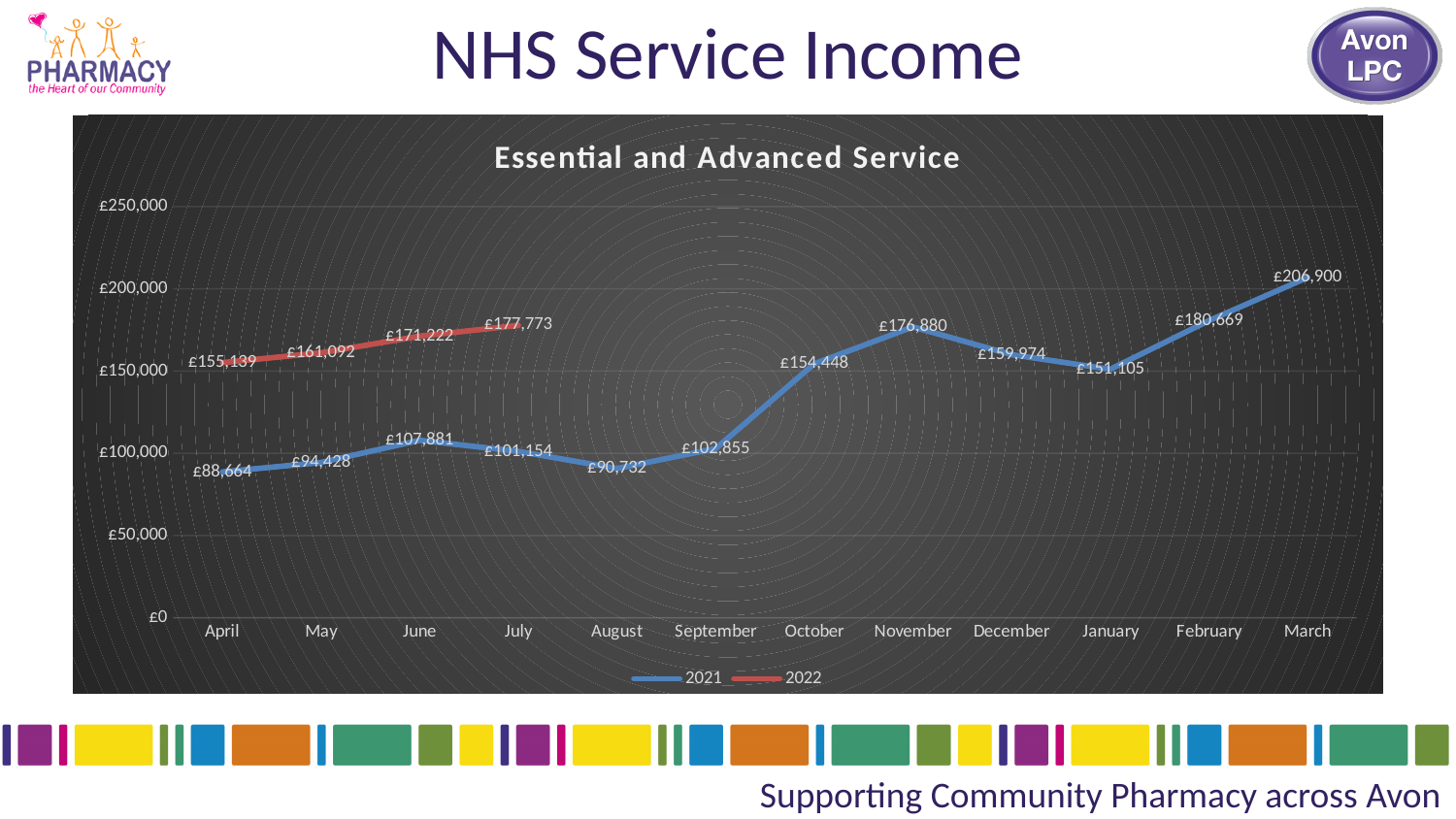
Which month has the lowest 2021 value? April What is the 2021 value for October? £154,448 Is the 2021 value for August greater or less than £100,000? less What is the difference between the 2022 and 2021 values for July? £76,619 How many series does the legend list? 2 What kind of chart is shown on the slide? Line chart Which month has the highest 2021 value? March Does the 2022 line rise or fall from April to July? Rises What is the title of the chart? Essential and Advanced Service What is the 2022 value for June? £171,222 Which is larger, the 2021 value for November or the 2021 value for February? February How many months are shown on the x axis? 12